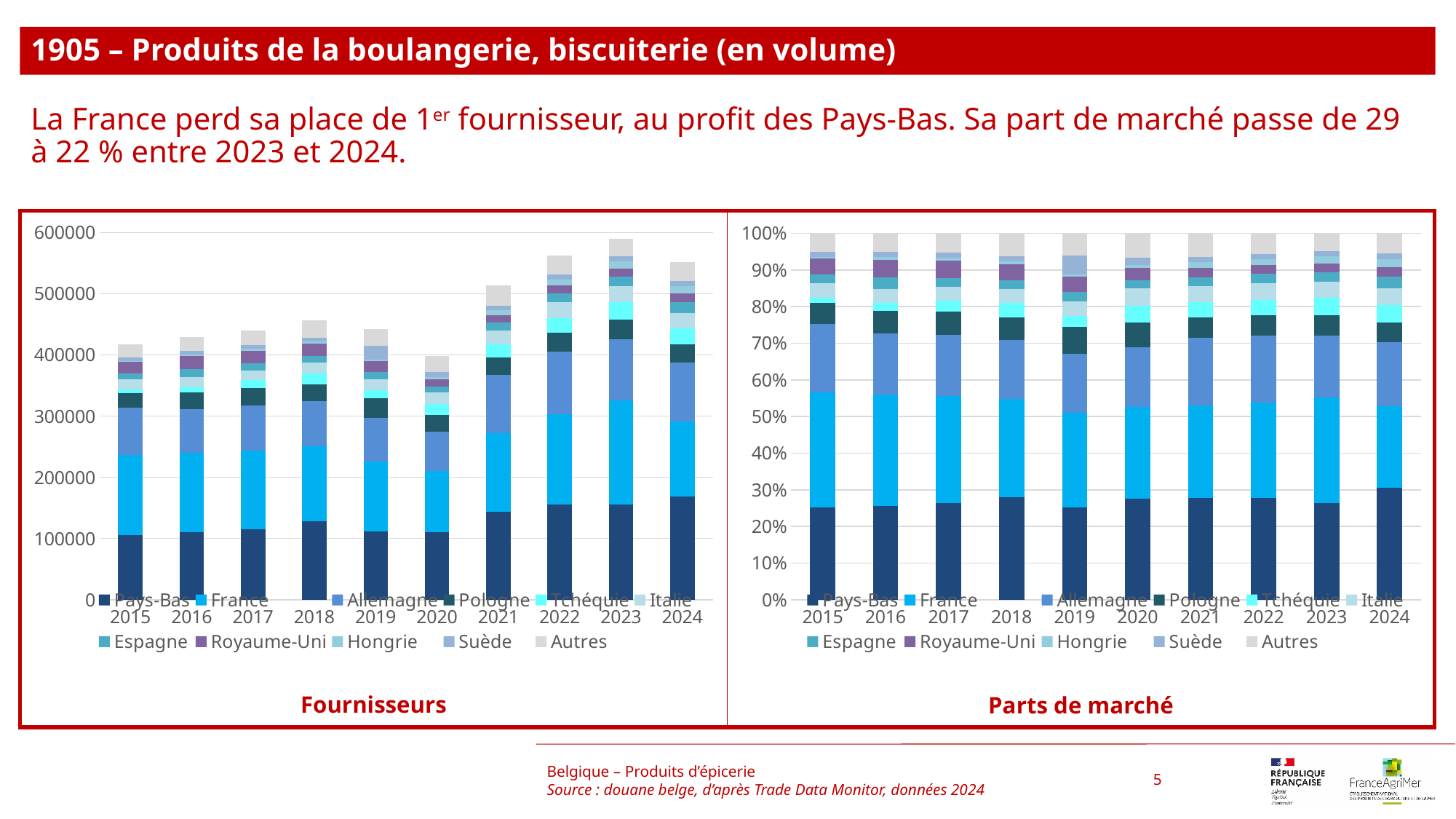
How many years are shown on the x axis of the 'Parts de marché' chart? 10 How many series does the legend of the 'Fournisseurs' chart list? 11 In the 'Fournisseurs' chart, which year has the tallest total bar? 2023 In the 'Fournisseurs' chart, is the total bar for 2023 greater or less than 500000? greater In the 'Fournisseurs' chart, is the total bar for 2015 greater or less than 500000? less In the 'Fournisseurs' chart, does the Pays-Bas segment generally rise or fall from 2015 to 2024? rise What is the title of the chart on the right side of the slide? Parts de marché In the 'Fournisseurs' chart, is the Pays-Bas segment for 2024 greater or less than 100000? greater In the 'Parts de marché' chart for 2024, which series has the larger share, Pays-Bas or France? Pays-Bas Which series is listed first in the legend of the 'Parts de marché' chart? Pays-Bas What kind of chart is the 'Fournisseurs' chart on the left? Stacked bar chart